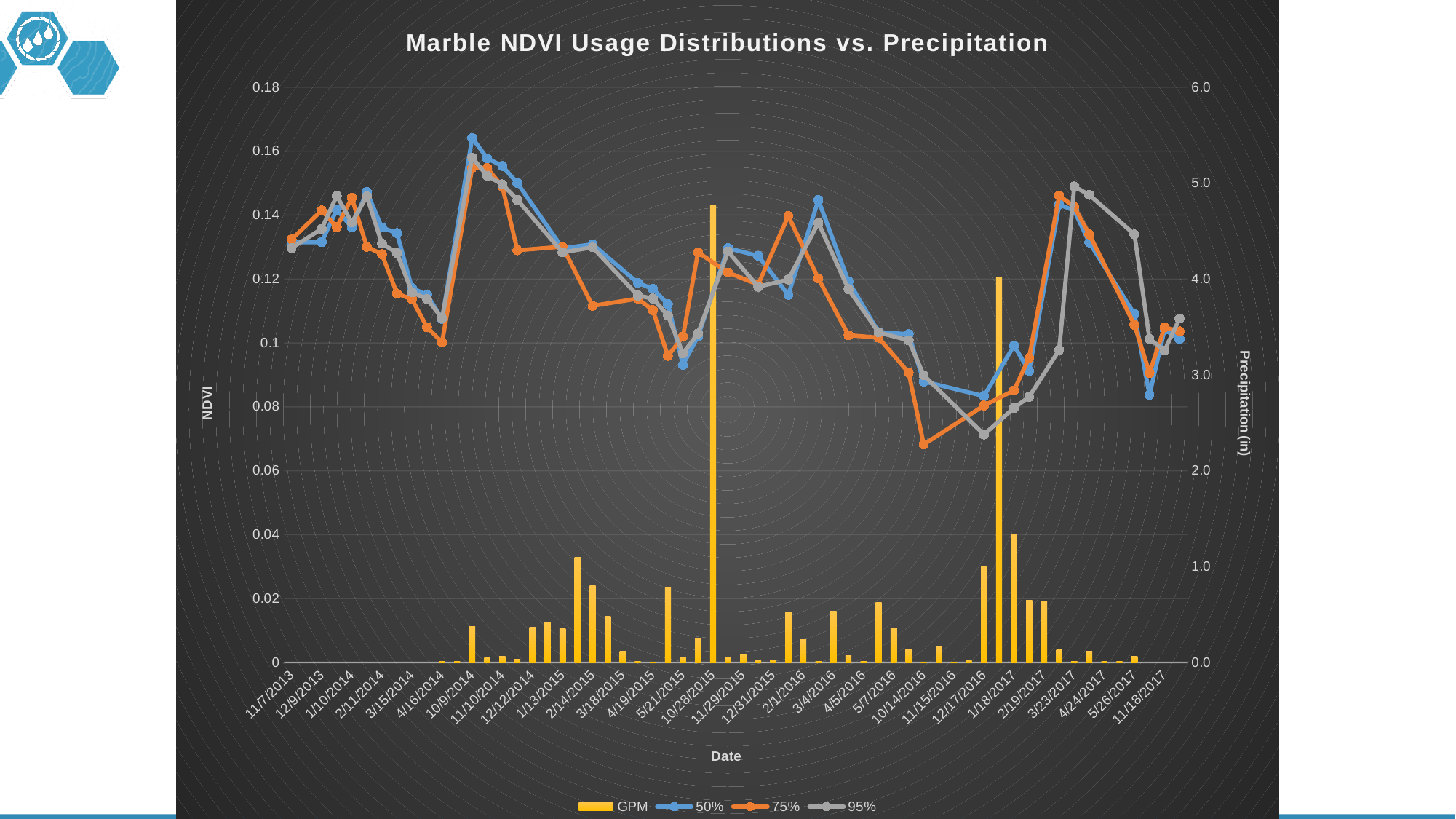
Does the 50% NDVI series rise or fall between 10/9/2014 and 5/21/2015? fall Is the tallest GPM precipitation bar (near 10/28/2015) greater or less than 4.0 inches? greater Is the 50% NDVI value at 10/9/2014 greater or less than 0.16? greater How many series does the legend list? 4 What is the title of the right-hand vertical axis? Precipitation (in) Is the 75% NDVI value at 10/14/2016 greater or less than 0.08? less What is the title of the chart? Marble NDVI Usage Distributions vs. Precipitation At which date does the 50% series reach its highest NDVI value? 10/9/2014 At which date does the 75% series reach its lowest NDVI value? 10/14/2016 At 10/14/2016, which series has the larger NDVI value, 50% or 75%? 50% What kind of chart is this? Combination bar and line chart